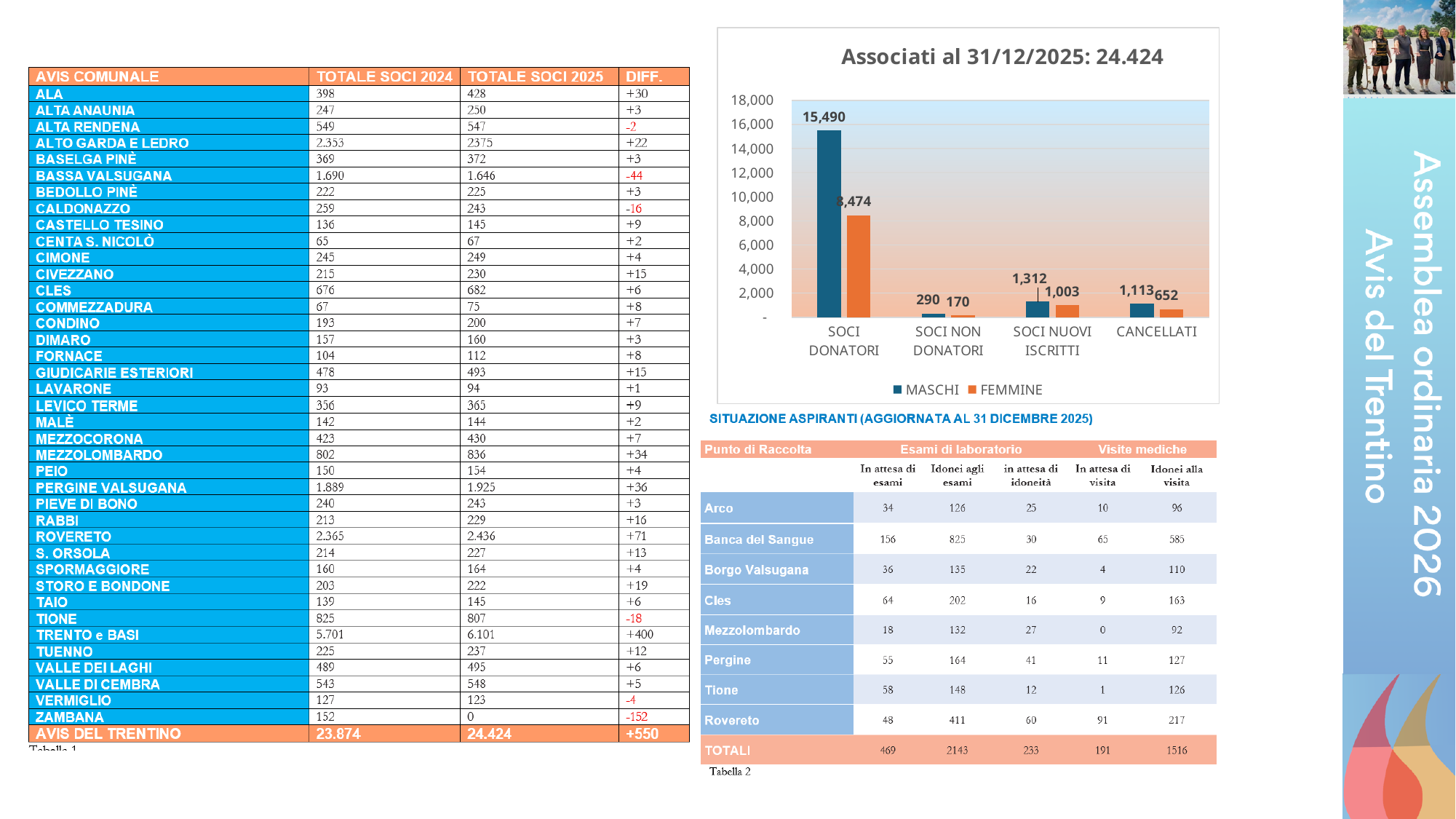
What is the title of the chart? Associati al 31/12/2025: 24.424 What is the MASCHI value for SOCI DONATORI? 15,490 What is the FEMMINE value for SOCI NUOVI ISCRITTI? 1,003 Which category has the highest MASCHI value? SOCI DONATORI What is the FEMMINE value for CANCELLATI? 652 What type of chart is shown on the slide? bar chart Which series is shown in orange in the chart? FEMMINE Which category has the lowest FEMMINE value? SOCI NON DONATORI What is the difference between the MASCHI and FEMMINE values for SOCI DONATORI? 7,016 How many series does the chart legend list? 2 How many categories are shown on the x axis of the chart? 4 Which is larger for SOCI NUOVI ISCRITTI, the MASCHI value or the FEMMINE value? MASCHI